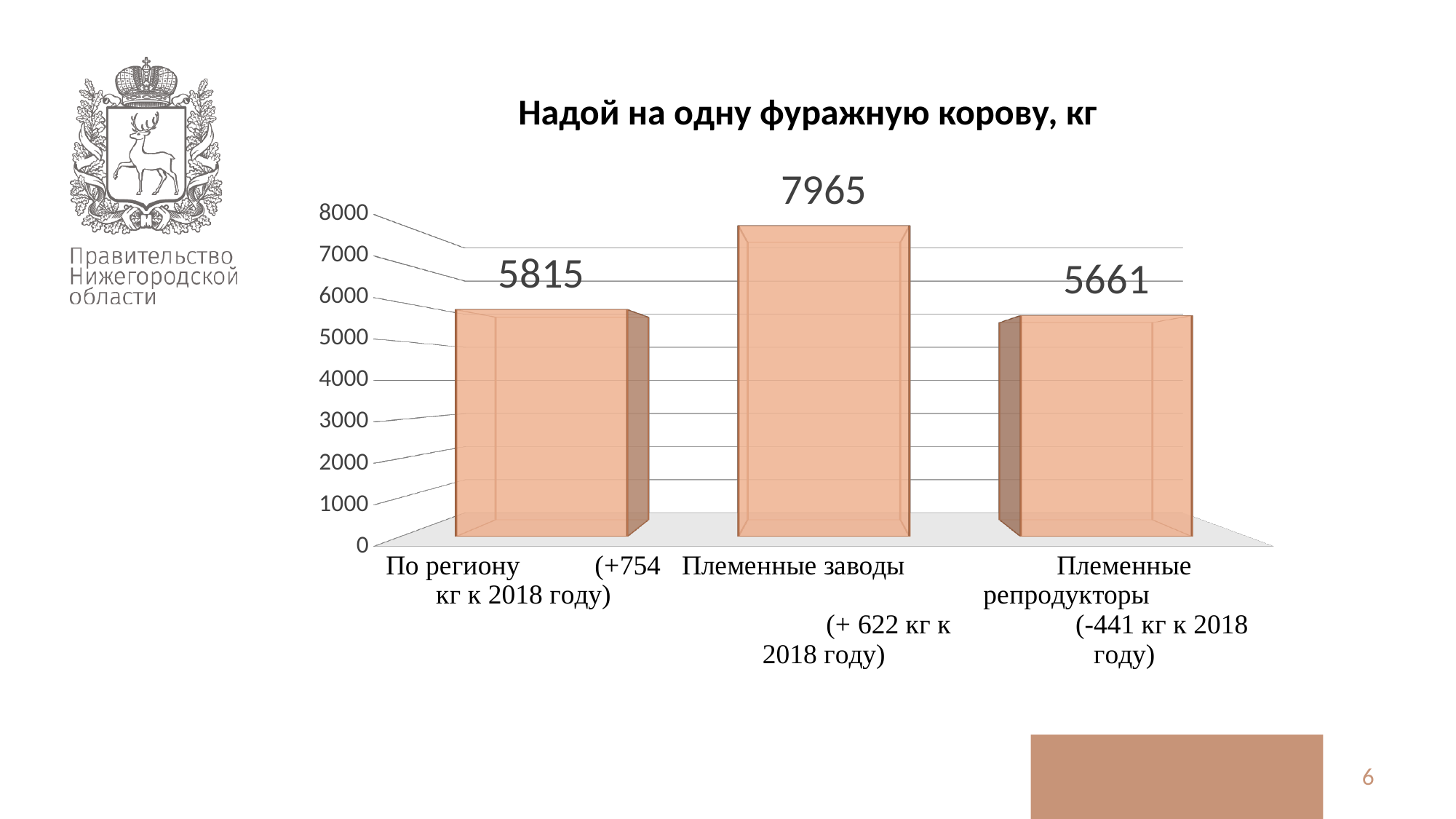
What is the value for «Племенные заводы»? 7965 What is the title of the chart? Надой на одну фуражную корову, кг Which category has the lowest value? Племенные репродукторы How many categories are shown in the chart? 3 What is the difference between the values for «Племенные заводы» and «По региону»? 2150 Which is larger: the value for «Племенные заводы» or «Племенные репродукторы»? Племенные заводы Which category has the highest value? Племенные заводы What is the value for «По региону» in the chart «Надой на одну фуражную корову, кг»? 5815 What is the value for «Племенные репродукторы»? 5661 What is the difference between the values for «По региону» and «Племенные репродукторы»? 154 Is the value for «Племенные заводы» greater or less than 7000? greater What kind of chart is shown on the slide? bar chart